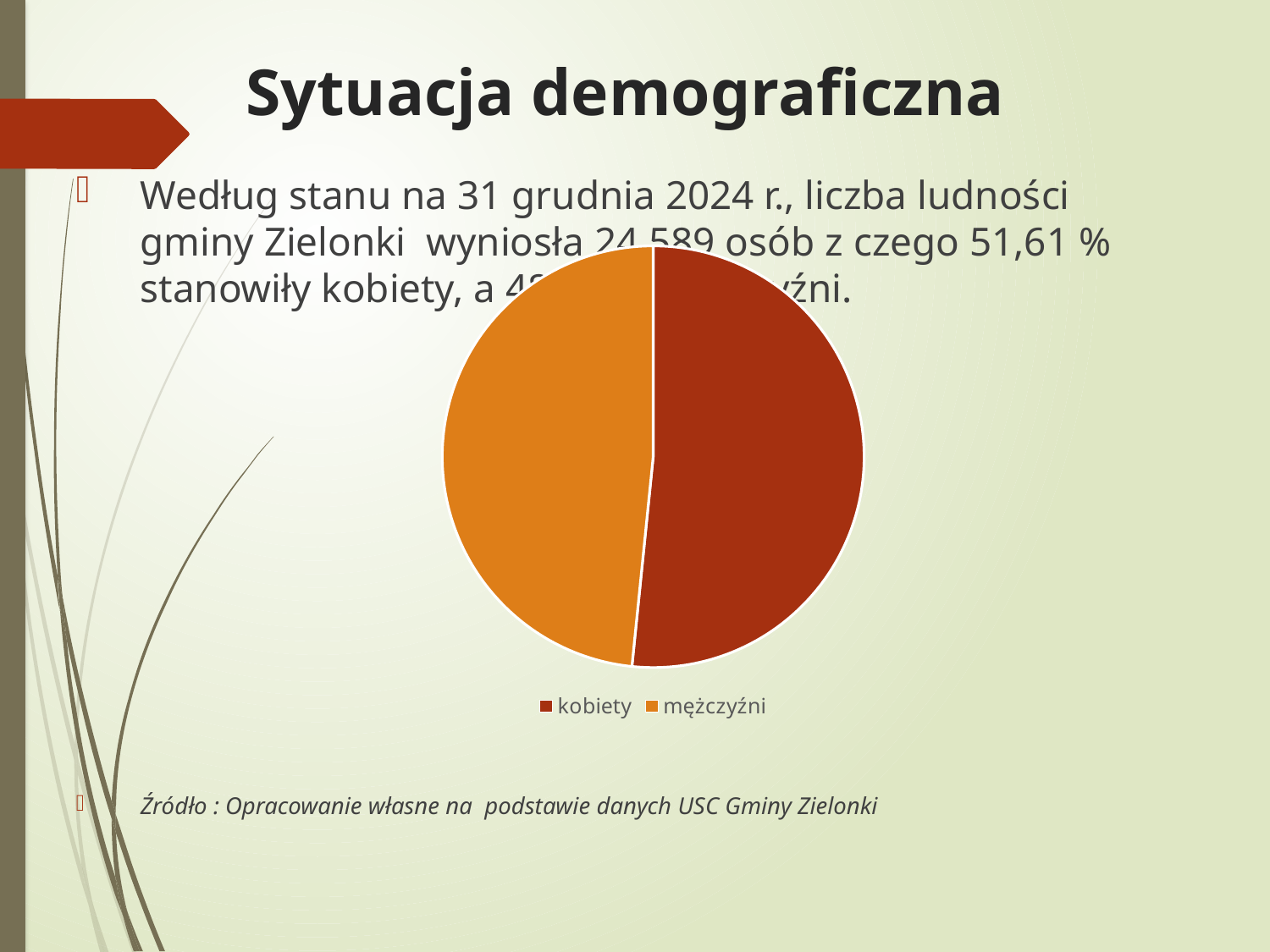
Is the share for kobiety greater or less than 50%? greater Which category has the largest share of the pie chart? kobiety What kind of chart is shown on the slide? pie chart According to the slide, what share of the population do kobiety (women) represent? 51,61 % Is the share for mężczyźni greater or less than 50%? less How many entries does the legend of the pie chart list? 2 How many slices does the pie chart have? 2 Which category has the smallest share of the pie chart? mężczyźni What are the two categories shown in the pie chart's legend? kobiety and mężczyźni Which slice of the pie chart is larger, kobiety or mężczyźni? kobiety What colour is the kobiety slice in the pie chart? dark red